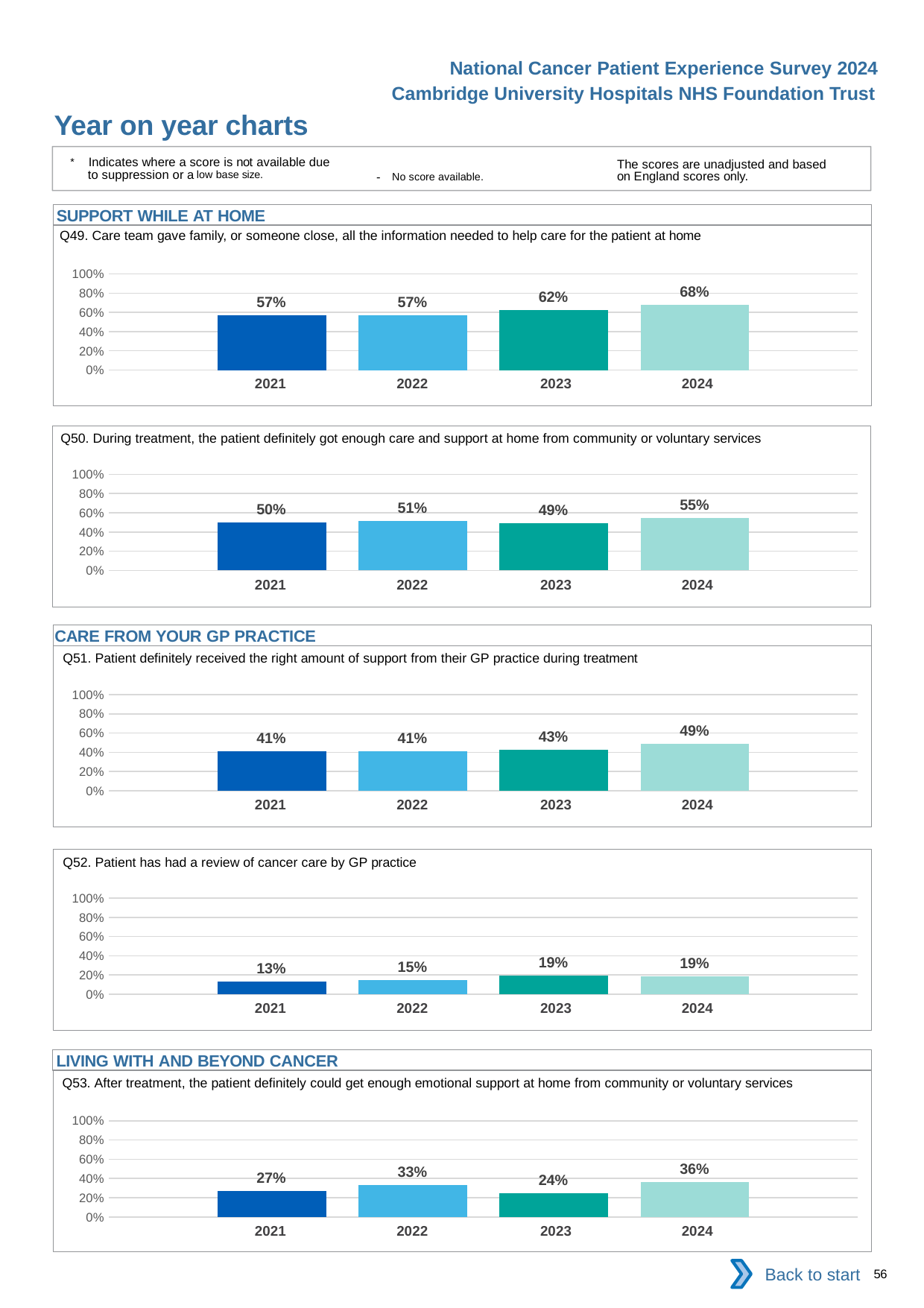
In the Q50 chart, what is the value for 2023? 49% What kind of chart is the Q49 chart? bar chart In the Q53 chart, what is the difference between the 2024 value and the 2023 value? 12 percentage points In the Q52 chart, do the values rise or fall from 2021 to 2023? rise In the Q53 chart, which is larger, the value for 2022 or the value for 2023? 2022 In the Q49 chart, which year has the highest value? 2024 In the Q49 chart, what is the value for 2024? 68% How many years are shown in the Q53 chart? 4 In the Q52 chart, what is the value for 2021? 13% In the Q51 chart, which year has the lowest value? 2021 and 2022 (both 41%) In the Q51 chart, is the value for 2024 greater or less than 40%? greater In the Q50 chart, what is the difference between the 2024 value and the 2021 value? 5 percentage points